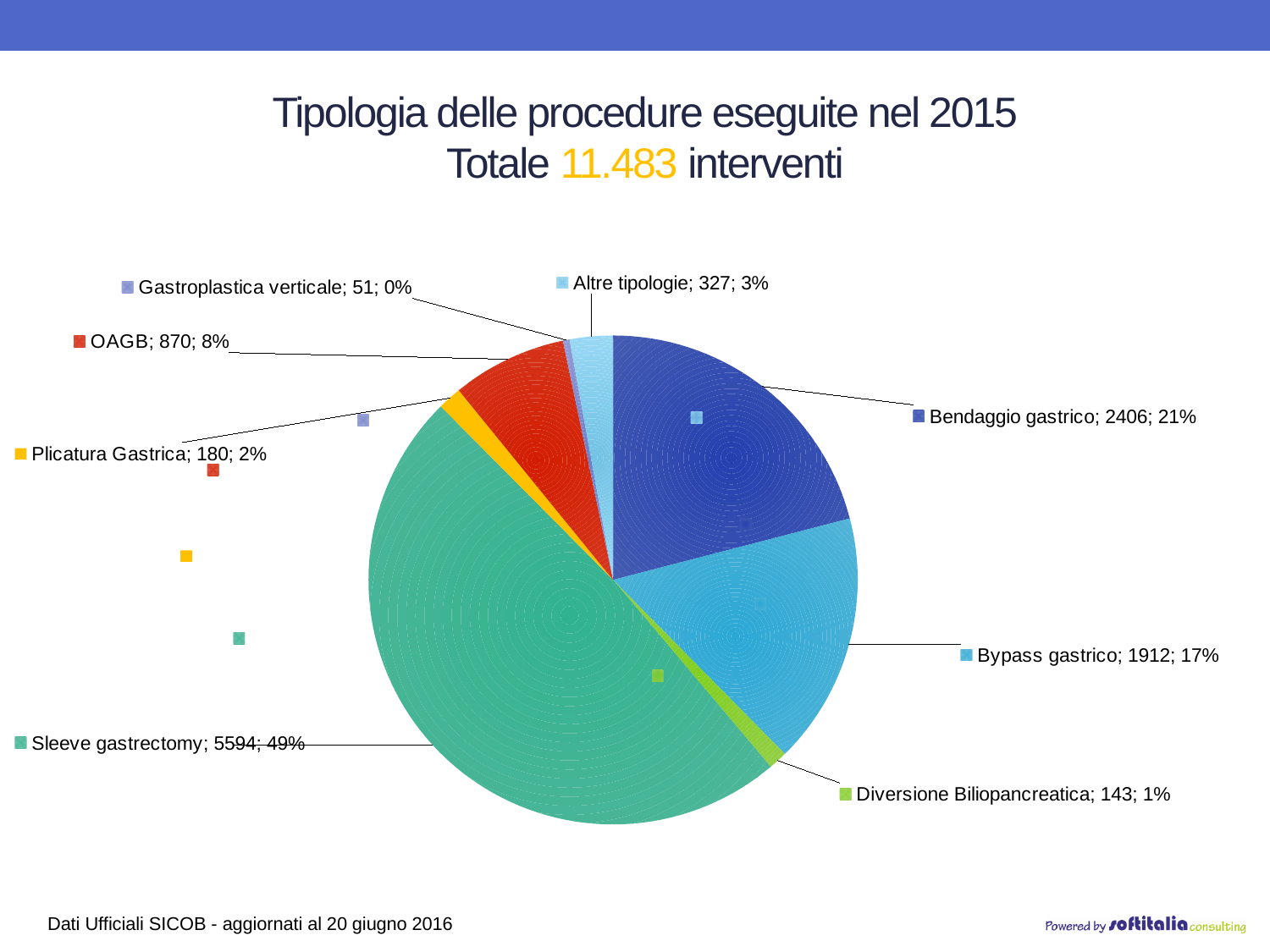
How many procedures of type Sleeve gastrectomy were performed in 2015? 5594 What share of the pie does Bendaggio gastrico represent? 21% What percentage is shown for Diversione Biliopancreatica? 1% What is the difference between the number of Bendaggio gastrico and Bypass gastrico procedures? 494 What is the total number of interventions stated in the chart title? 11.483 How many Bypass gastrico procedures are shown? 1912 How many slices does the pie chart have? 8 Which procedure type has the smallest slice of the pie? Gastroplastica verticale How many Plicatura Gastrica procedures are shown? 180 What kind of chart is shown on the slide? pie chart Which procedure type has the largest slice of the pie? Sleeve gastrectomy Which is larger: the number of OAGB procedures or the number of Altre tipologie procedures? OAGB